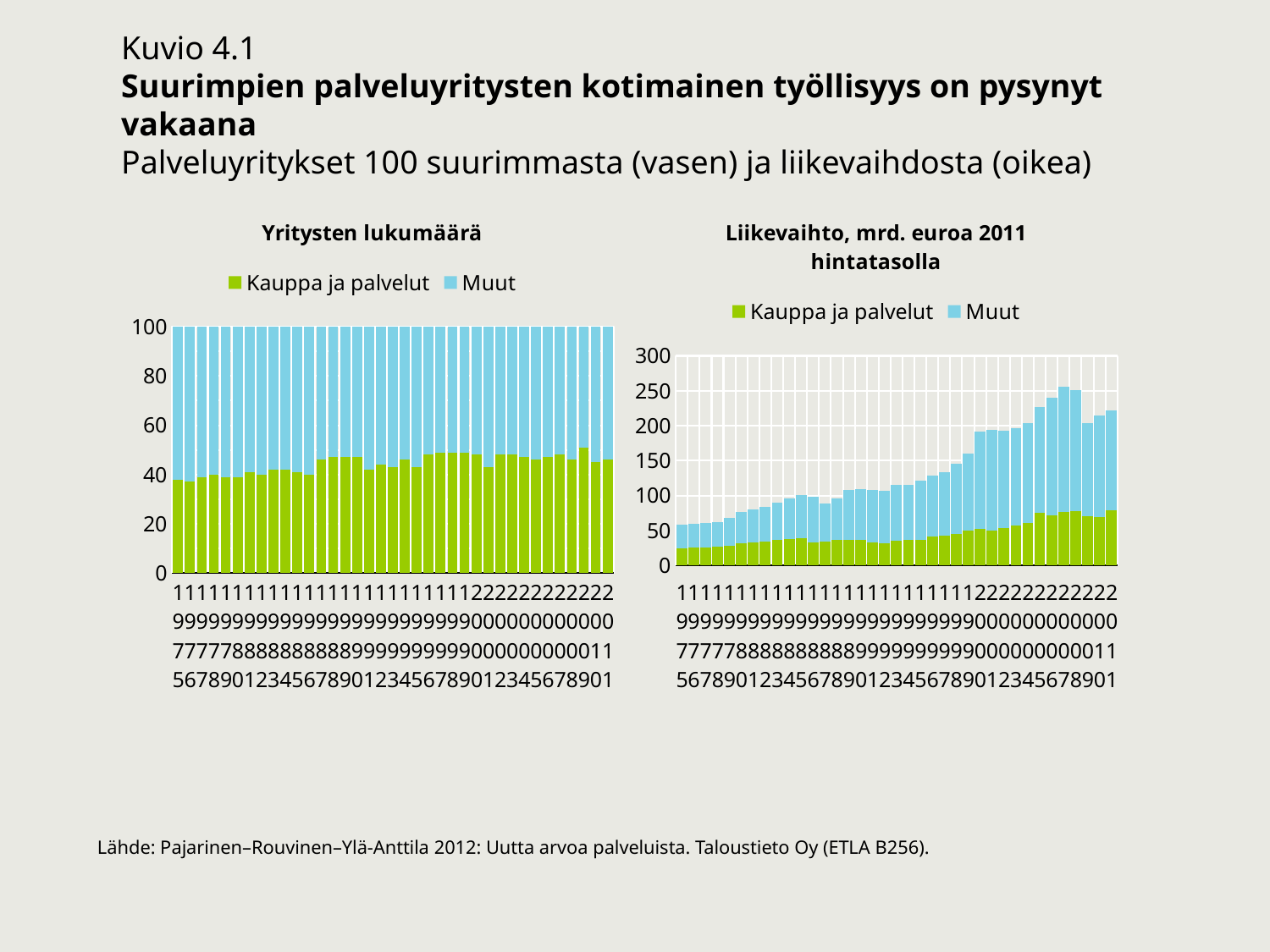
In the right chart "Liikevaihto, mrd. euroa 2011 hintatasolla", is the Kauppa ja palvelut value for 2011 greater or less than 50? greater In the right chart "Liikevaihto, mrd. euroa 2011 hintatasolla", does the total turnover generally rise or fall from 1975 to 2011? rise What kind of chart is the left chart titled "Yritysten lukumäärä"? Stacked bar chart How many series does the legend of the right chart "Liikevaihto, mrd. euroa 2011 hintatasolla" list? 2 In the left chart "Yritysten lukumäärä", which series is larger in 1975, Kauppa ja palvelut or Muut? Muut In the right chart "Liikevaihto, mrd. euroa 2011 hintatasolla", is the total for 2011 greater or less than 200? greater In the left chart "Yritysten lukumäärä", what is the total height of the stacked bar for 1975? 100 In the left chart "Yritysten lukumäärä", how many years (bars) are plotted? 37 What are the two legend entries of the left chart "Yritysten lukumäärä"? Kauppa ja palvelut and Muut In the right chart "Liikevaihto, mrd. euroa 2011 hintatasolla", is the total for 1975 greater or less than 100? less In the right chart "Liikevaihto, mrd. euroa 2011 hintatasolla", which series is larger in 2011, Kauppa ja palvelut or Muut? Muut